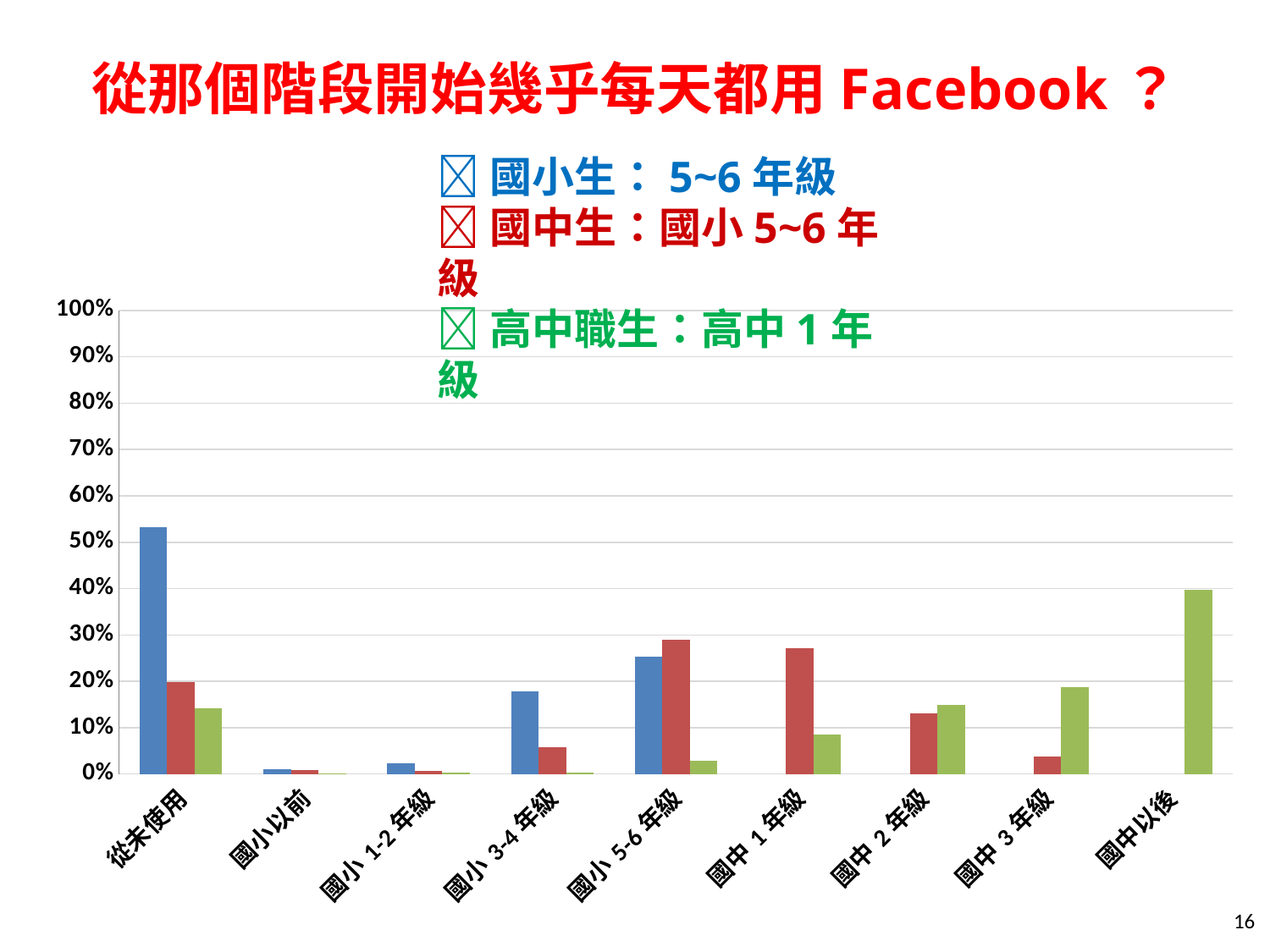
Which category has the tallest blue bar? 從未使用 Is the blue bar for 從未使用 greater or less than 50%? greater How many categories are shown along the x axis of the chart? 9 For 國中 3 年級, which bar is taller, the red one or the green one? the green one Is the red bar for 國中 1 年級 greater or less than 20%? greater What kind of chart is shown on the slide? bar chart How many different bar colours are used in the chart? 3 Is the green bar for 國中以後 greater or less than 30%? greater Which category has the tallest green bar? 國中以後 For 從未使用, which bar is taller, the blue one or the red one? the blue one What is the highest value shown on the y axis of the chart? 100%